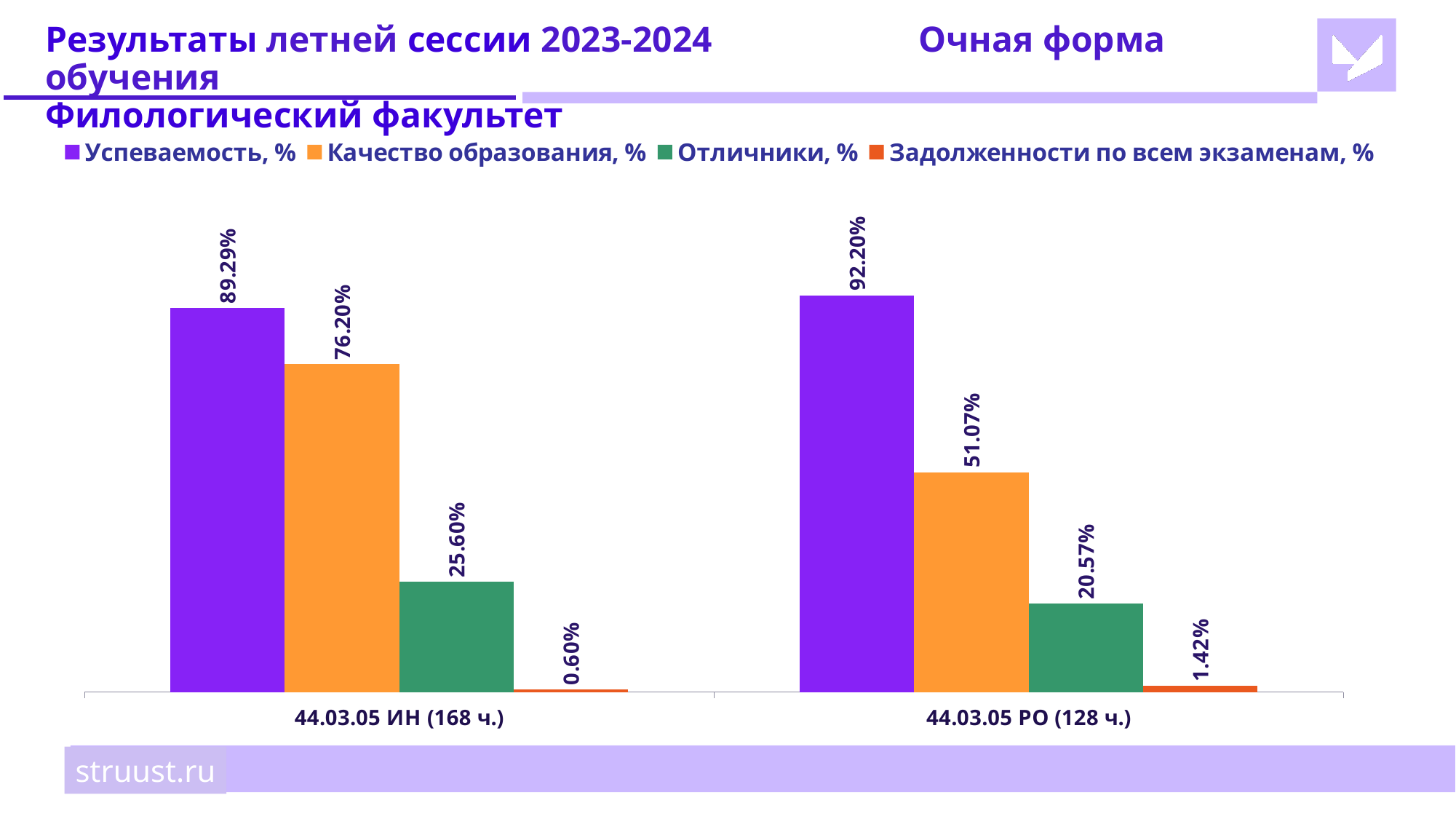
What is the value of Задолженности по всем экзаменам, % for 44.03.05 РО (128 ч.)? 1.42% Is Отличники, % larger for 44.03.05 ИН (168 ч.) or for 44.03.05 РО (128 ч.)? 44.03.05 ИН (168 ч.) Which category has the lower value for Качество образования, %? 44.03.05 РО (128 ч.) What is the value of Качество образования, % for 44.03.05 РО (128 ч.)? 51.07% How many categories are shown on the x axis of the chart? 2 What is the value of Успеваемость, % for 44.03.05 ИН (168 ч.)? 89.29% What kind of chart is shown on the slide? Bar chart Which category has the higher value for Успеваемость, %? 44.03.05 РО (128 ч.) What is the difference between Качество образования, % for 44.03.05 ИН (168 ч.) and for 44.03.05 РО (128 ч.)? 25.13% How many series does the legend list? 4 What is the value of Отличники, % for 44.03.05 ИН (168 ч.)? 25.60% What is the difference between Успеваемость, % for 44.03.05 РО (128 ч.) and for 44.03.05 ИН (168 ч.)? 2.91%